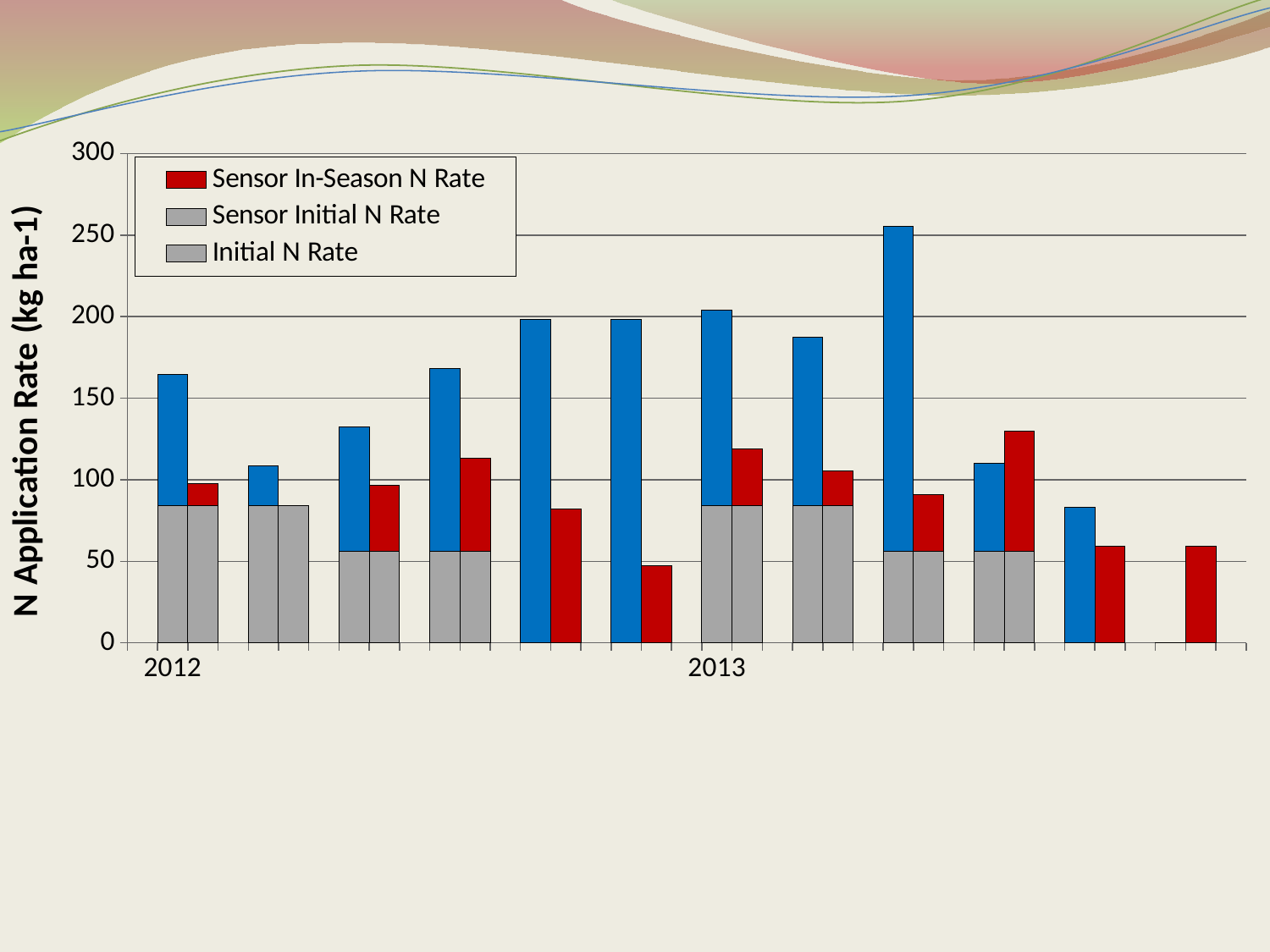
What kind of chart is shown on the slide? bar chart How many series does the legend list? 3 Which colour represents Sensor In-Season N Rate in the legend? red In the first group of bars (labelled 2012), which is taller, the blue bar or the red bar? the blue bar Is the blue bar in the first group (labelled 2012) greater or less than 150? greater How many groups of bars are plotted along the x axis? 12 What is the title of the vertical axis? N Application Rate (kg ha-1) Is the tallest bar in the chart greater or less than 200? greater Is the tallest red bar in the chart greater or less than 100? greater